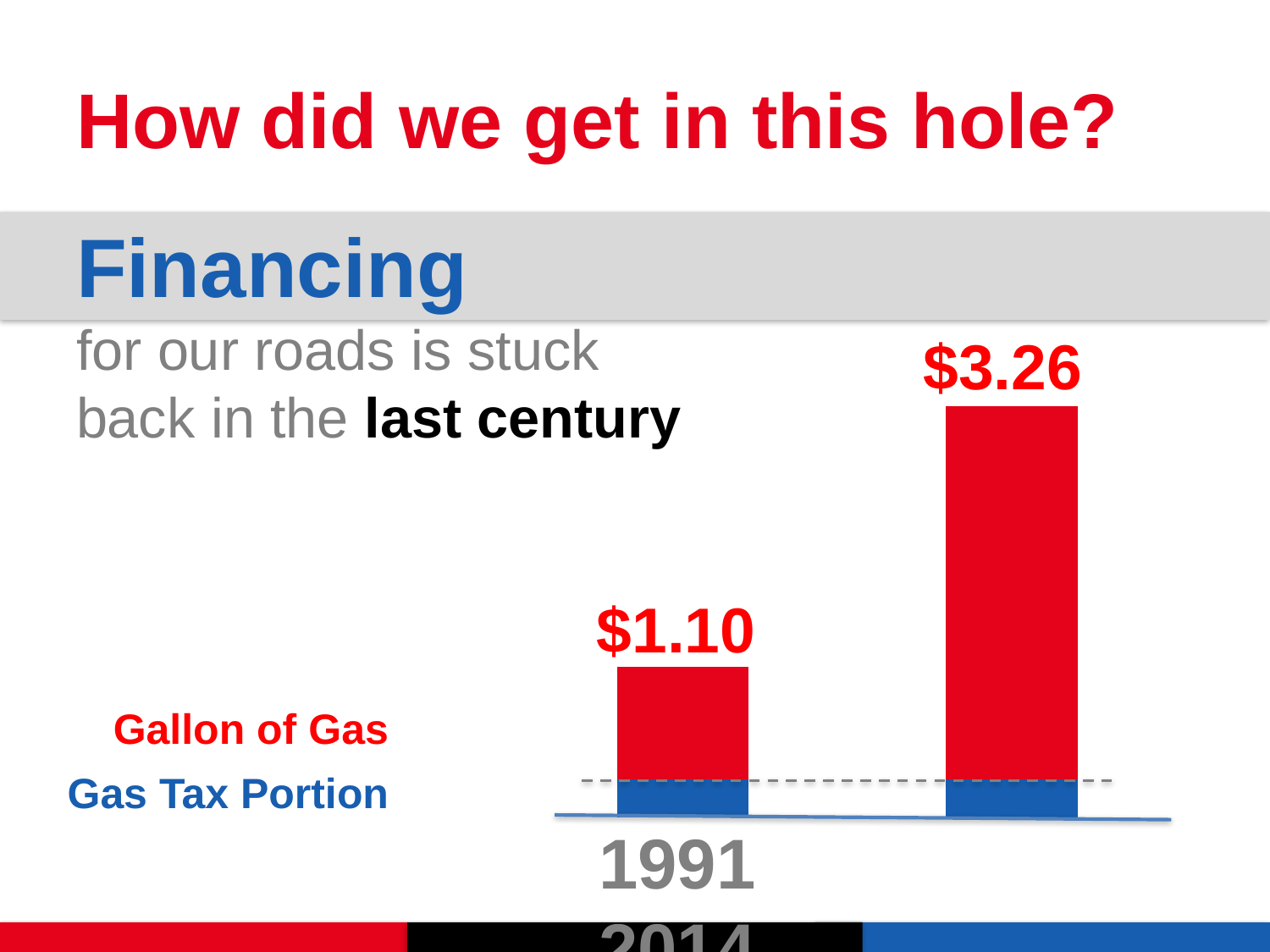
What colour represents the Gas Tax Portion series? blue Which series is shown in red? Gallon of Gas What is the difference between the $3.26 bar and the $1.10 bar? $2.16 Which bar is the tallest, the 1991 bar or the right-hand bar? the right-hand (2014) bar What is the value shown for the right-hand (2014) bar? $3.26 What kind of chart is shown on the slide? bar chart Is the value for 1991 larger or smaller than the value for the right-hand bar? smaller Do the bar values rise or fall from the left bar to the right bar? rise What is the value shown for the 1991 bar? $1.10 How many bars are plotted in the chart? 2 Which bar has the lowest value? 1991